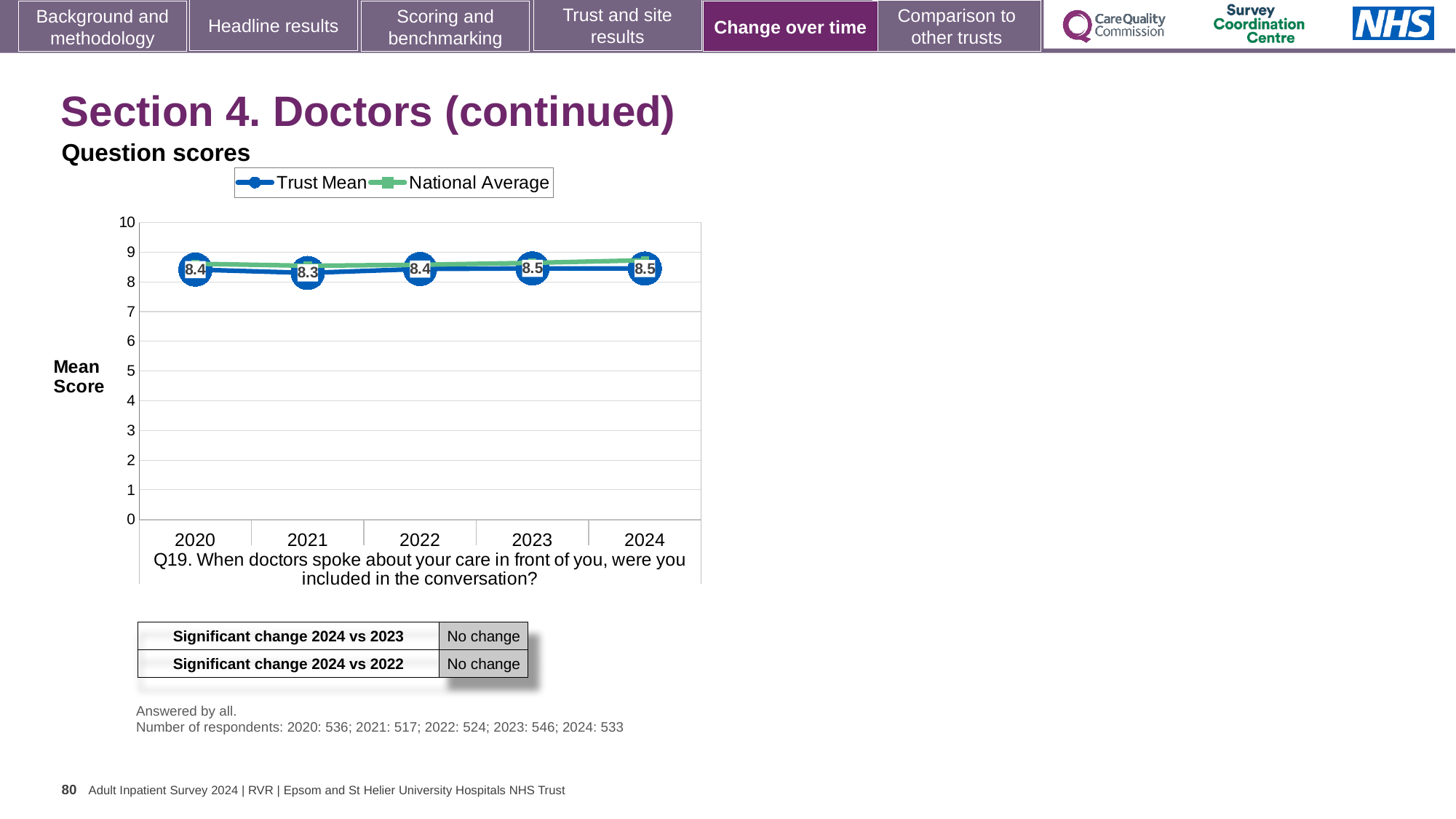
Is the National Average value for 2024 greater or less than 8? greater Does the Trust Mean score rise or fall from 2021 to 2024? Rise What kind of chart is shown on the slide? Line chart How many series does the legend list? 2 What is the Trust Mean score for 2024? 8.5 What is the Trust Mean score for 2021? 8.3 What is the Trust Mean score for 2020? 8.4 Which year has the larger Trust Mean score, 2021 or 2023? 2023 Which question does the chart show scores for? Q19. When doctors spoke about your care in front of you, were you included in the conversation? In which year is the Trust Mean score lowest? 2021 What is the difference between the Trust Mean score in 2024 and in 2021? 0.2 How many years are plotted on the x axis? 5